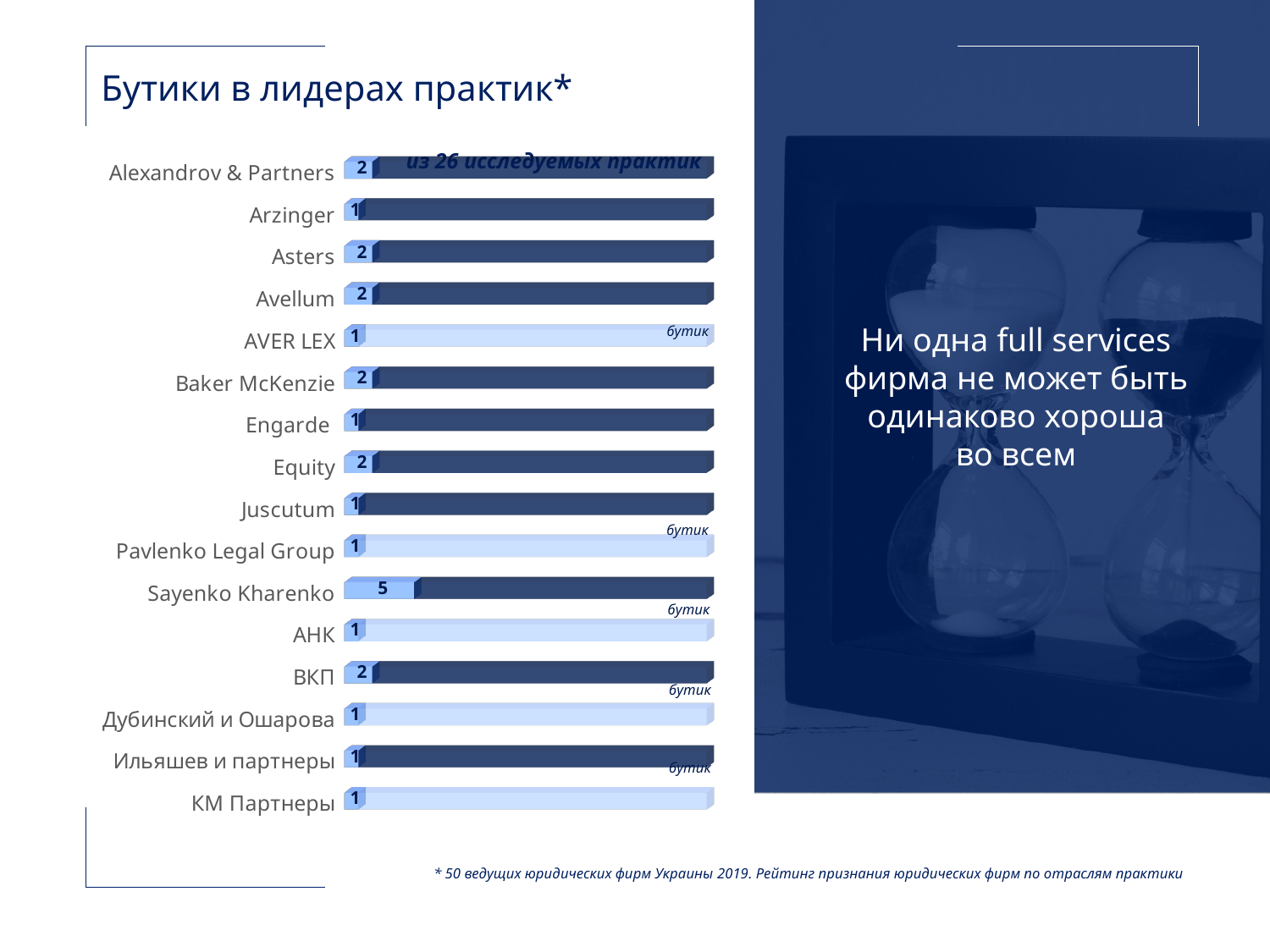
What value is shown for Sayenko Kharenko? 5 What value is shown for AVER LEX? 1 What value is shown for Pavlenko Legal Group? 1 What is the difference between the values for Sayenko Kharenko and Asters? 3 Which firm has the highest value in the chart? Sayenko Kharenko Which has the larger value, Sayenko Kharenko or Avellum? Sayenko Kharenko How many firms are listed in the chart? 16 How many firms in the chart are marked with the label "бутик"? 5 What value is shown for ВКП? 2 What is the title of the slide containing the chart? Бутики в лидерах практик* What value is shown for Alexandrov & Partners? 2 What kind of chart is shown on the slide? Bar chart